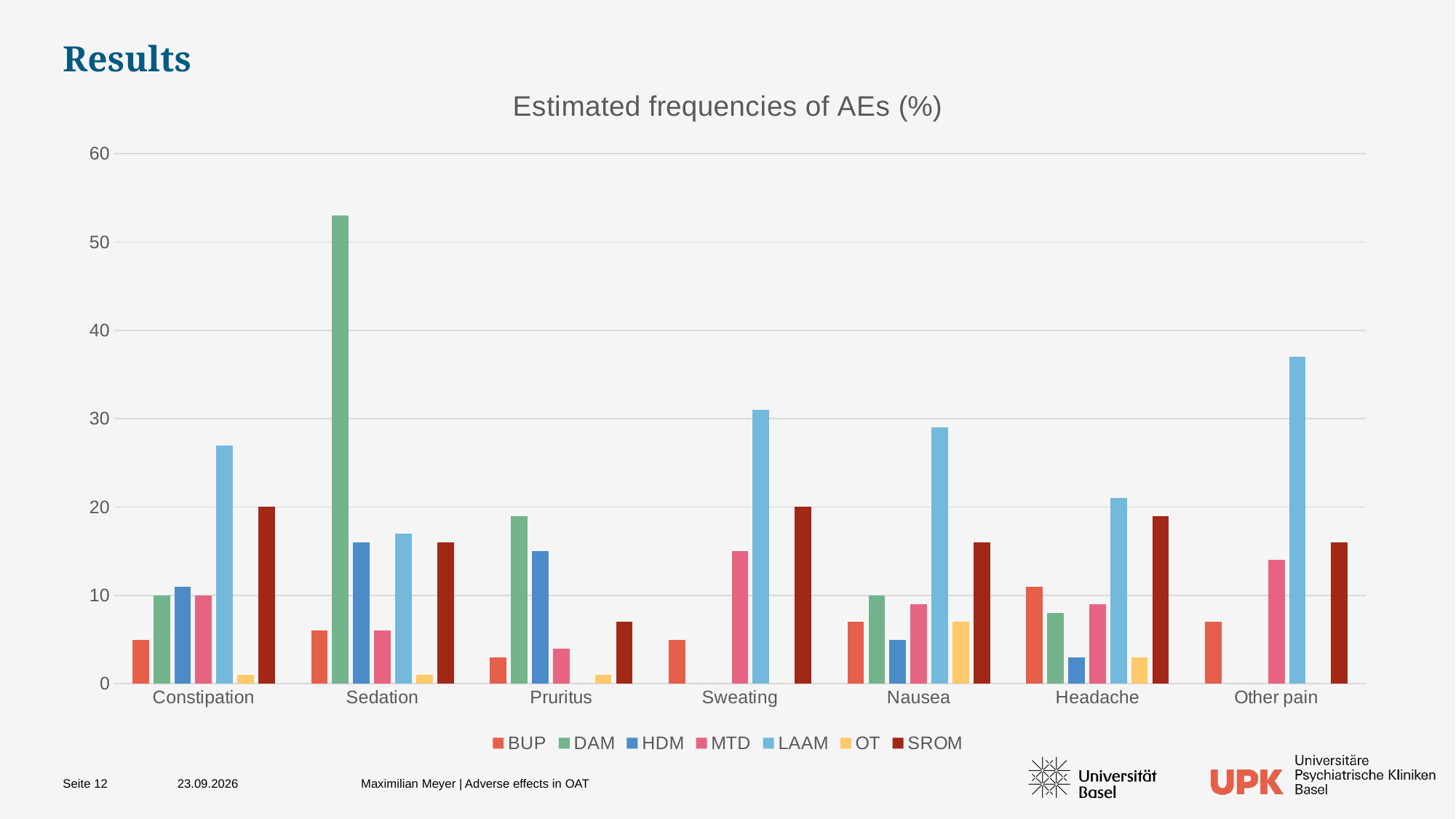
Which is larger: LAAM for Nausea or LAAM for Headache? LAAM for Nausea What kind of chart is shown on the slide? bar chart Is the value for HDM under Sedation greater or less than 10? greater Is the value for DAM under Sedation greater or less than 50? greater Is the value for LAAM under Other pain greater or less than 30? greater Within the Sedation category, which series has the lowest bar? OT What is the title of the chart? Estimated frequencies of AEs (%) How many adverse event categories are shown on the x axis? 7 How many series does the legend list? 7 For Sweating, which is larger: LAAM or SROM? LAAM Which series has the tallest bar in the whole chart, and for which category? DAM, Sedation